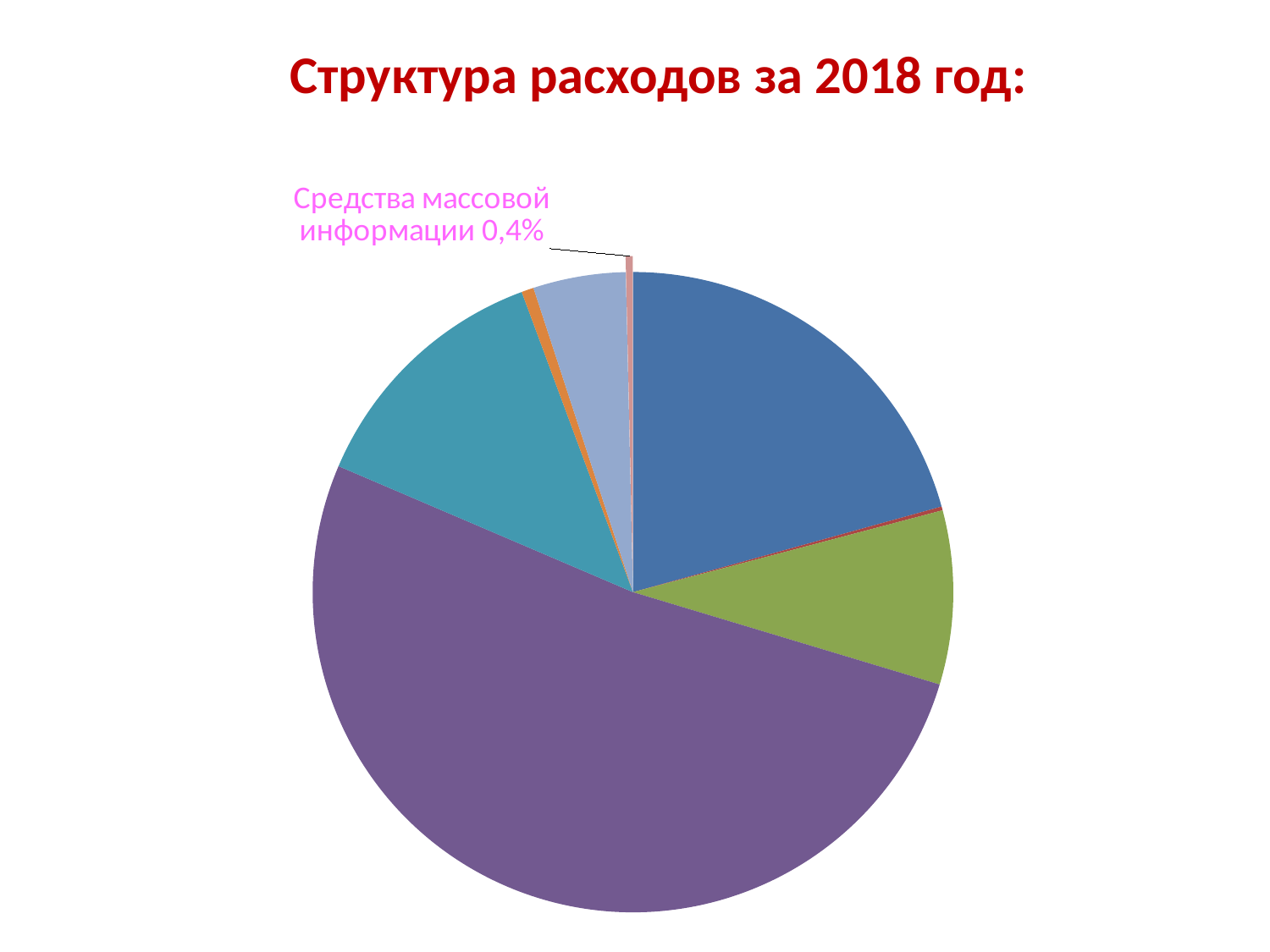
Does the Средства массовой информации slice take up more or less than half of the pie? less What kind of chart is shown on the slide? pie chart What is the title of the chart? Структура расходов за 2018 год: What colour is the largest slice of the pie? purple Which is larger: the Средства массовой информации slice or the purple slice? the purple slice What share of expenses is labelled for Средства массовой информации? 0,4% Is the share for Средства массовой информации greater or less than 1%? less